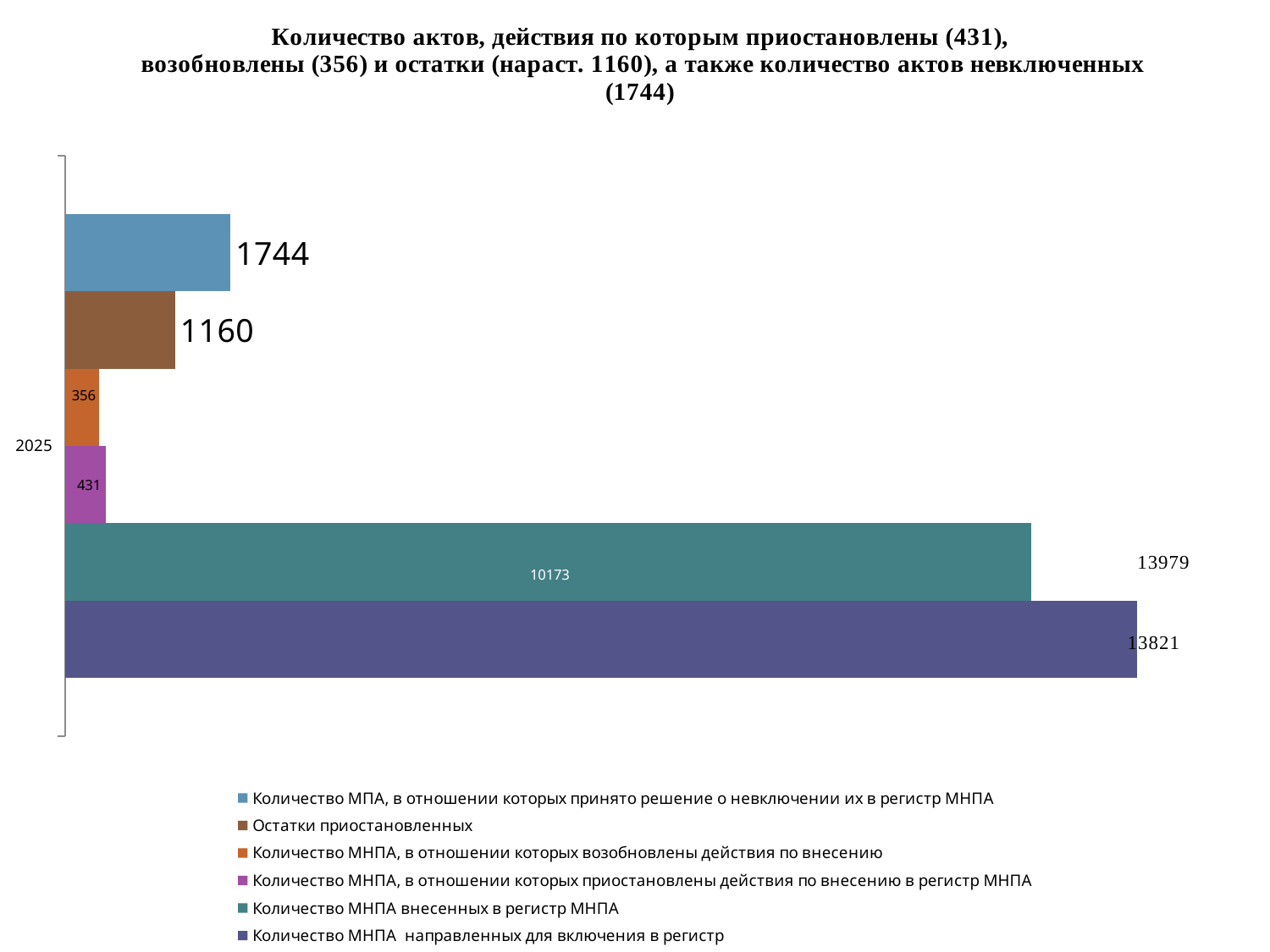
What is the value for the series "Количество МПА, в отношении которых принято решение о невключении их в регистр МНПА"? 1744 How many series does the legend list? 6 Which series has the highest value? Количество МНПА направленных для включения в регистр What kind of chart is shown on the slide? Bar chart Which is larger: the value for "Остатки приостановленных" or the value for "Количество МПА, в отношении которых принято решение о невключении их в регистр МНПА"? Количество МПА, в отношении которых принято решение о невключении их в регистр МНПА Which series has the lowest value? Количество МНПА, в отношении которых возобновлены действия по внесению What is the value for the series "Количество МНПА, в отношении которых приостановлены действия по внесению в регистр МНПА"? 431 What is the value for the series "Остатки приостановленных"? 1160 What is the difference between the value for acts with suspended actions (приостановлены) and the value for acts with resumed actions (возобновлены)? 75 What is the value for the series "Количество МНПА, в отношении которых возобновлены действия по внесению"? 356 What is the difference between the value for "Количество МПА, в отношении которых принято решение о невключении их в регистр МНПА" and the value for "Остатки приостановленных"? 584